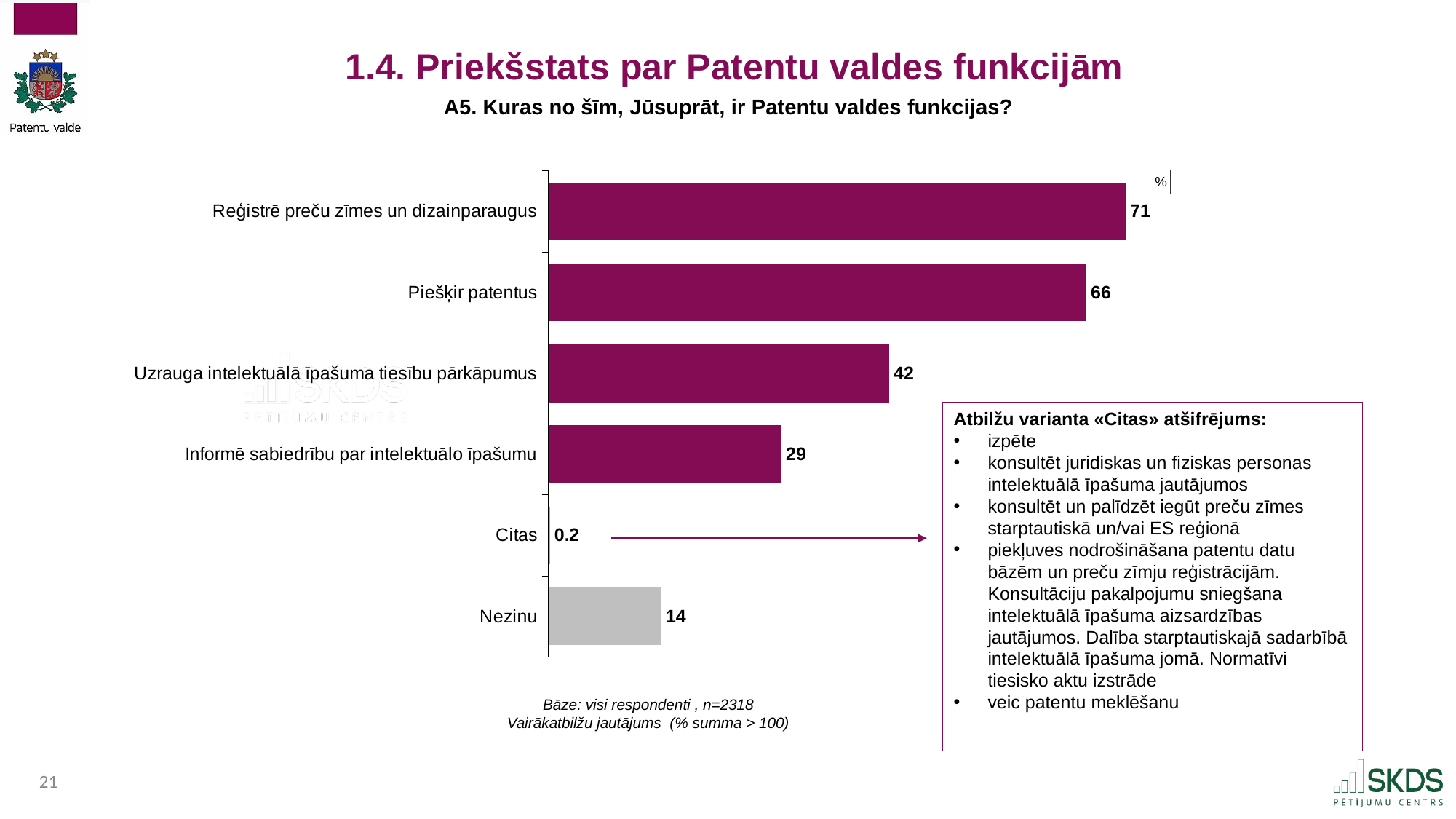
What is the value for "Citas"? 0.2 Which is larger: the value for "Uzrauga intelektuālā īpašuma tiesību pārkāpumus" or the value for "Informē sabiedrību par intelektuālo īpašumu"? Uzrauga intelektuālā īpašuma tiesību pārkāpumus What is the value for "Reģistrē preču zīmes un dizainparaugus"? 71 Which category has the lowest value? Citas How many categories are shown in the chart? 6 What is the difference between the values for "Piešķir patentus" and "Informē sabiedrību par intelektuālo īpašumu"? 37 What is the value for "Piešķir patentus"? 66 What kind of chart is shown on the slide? Bar chart Which category has the highest value? Reģistrē preču zīmes un dizainparaugus What is the value for "Nezinu"? 14 What is the value for "Uzrauga intelektuālā īpašuma tiesību pārkāpumus"? 42 Which bar is shown in grey rather than purple? Nezinu